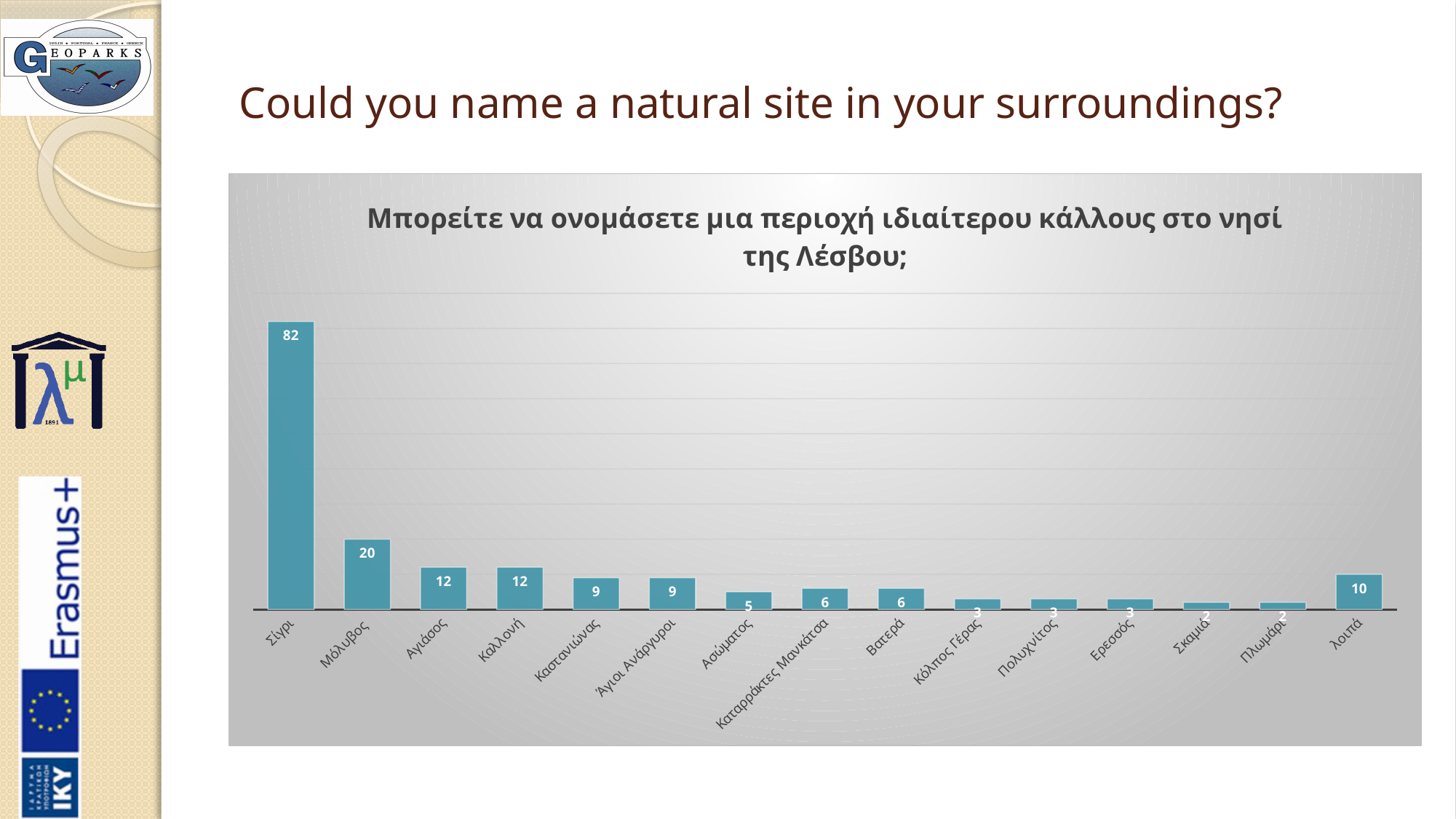
Which has a larger value, Καστανιώνας or Ασώματος? Καστανιώνας Which category has the highest value? Σίγρι Which has a larger value, λοιπά or Ερεσσός? λοιπά What value is shown for Σίγρι? 82 What kind of chart is shown on the slide? Bar chart What is the title of the slide? Could you name a natural site in your surroundings? What value is shown for λοιπά? 10 What value is shown for Μόλυβος? 20 How many categories are shown on the x axis? 15 What value is shown for Βατερά? 6 What is the difference between the values for Σίγρι and Μόλυβος? 62 What is the difference between the values for Μόλυβος and Αγιάσος? 8